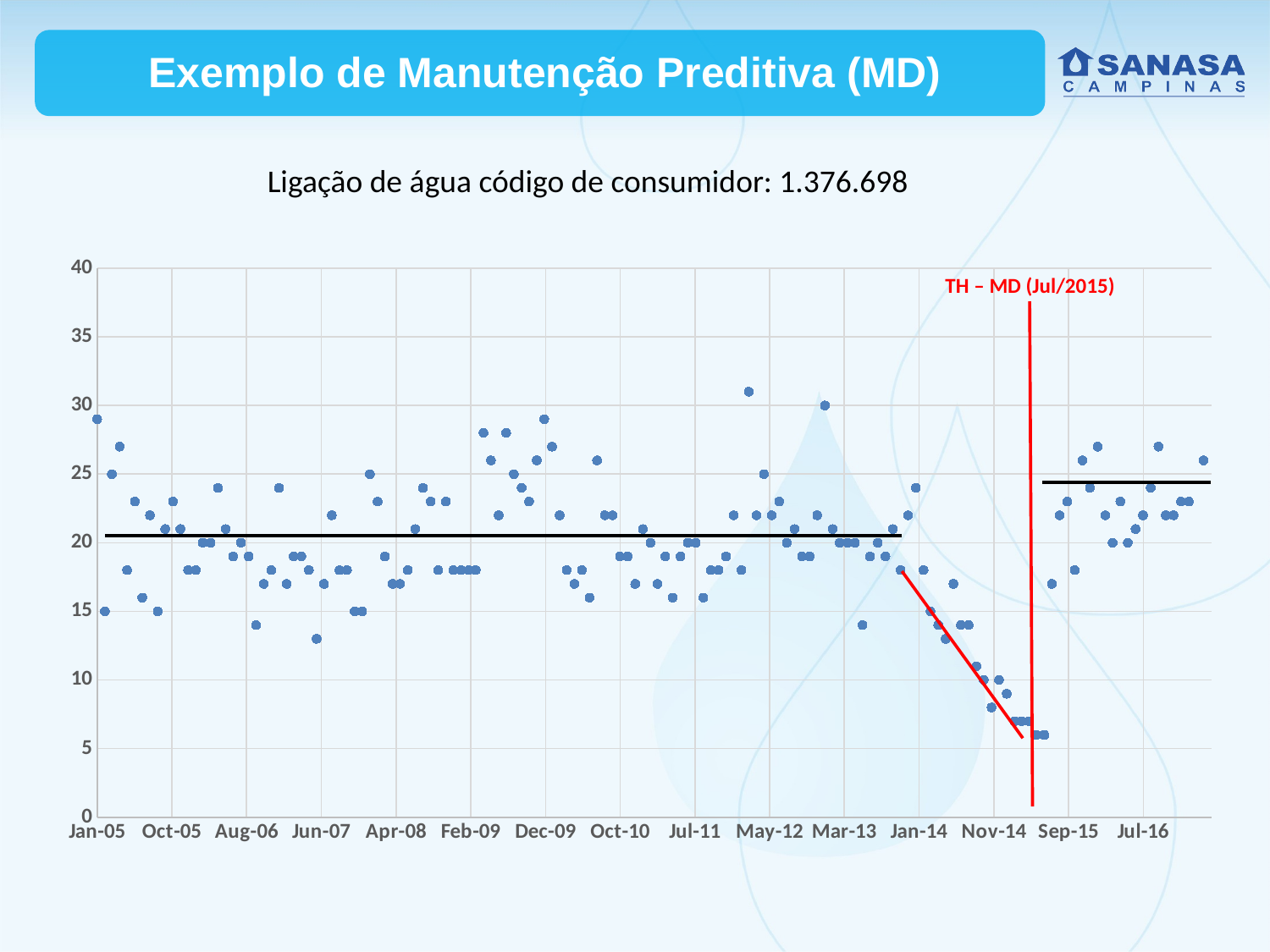
What is the subtitle printed above the chart? Ligação de água código de consumidor: 1.376.698 What is the text of the red annotation above the vertical red line? TH – MD (Jul/2015) What is the highest value shown on the vertical axis? 40 What is the last label on the horizontal axis? Jul-16 Is the black horizontal line on the right side of the chart (after Sep-15) higher or lower than the black horizontal line on the left side? higher Are the points plotted just before the red vertical line (around mid-2015) greater or less than 10? less What kind of chart is shown on the slide? scatter chart Is the highest point on the chart, near May-12, greater or less than 30? greater What is the first label on the horizontal axis? Jan-05 Do the values rise or fall between Jan-14 and the red vertical line at Jul/2015? fall How many labels are printed along the horizontal axis? 15 Is the value of the first point at Jan-05 greater or less than 25? greater